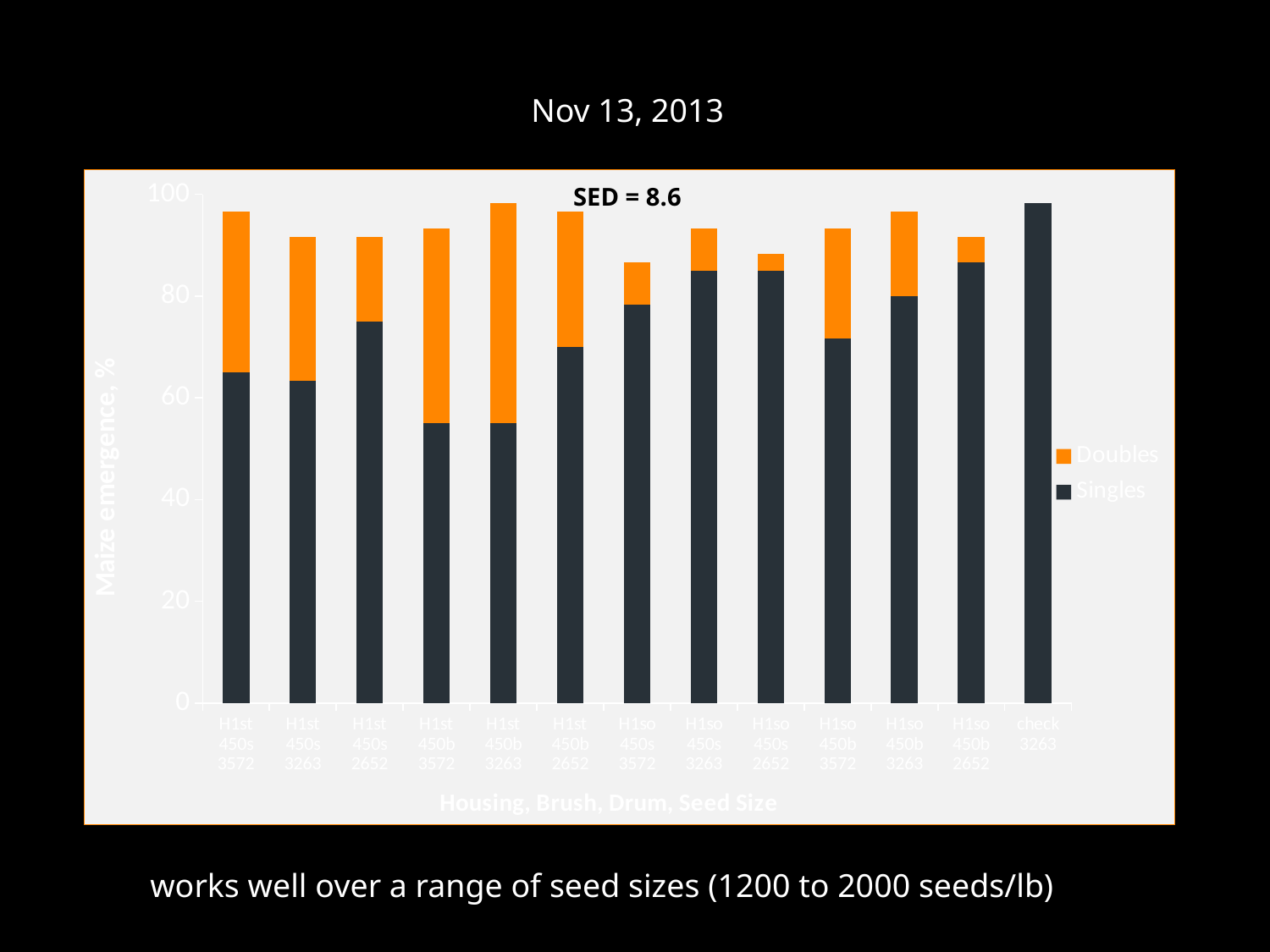
Is the Singles value for check 3263 greater or less than 80? greater How many series does the legend list? 2 Which has the larger Doubles value, H1st 450b 3263 or H1so 450s 3263? H1st 450b 3263 What SED value is printed on the chart? SED = 8.6 How many categories are plotted along the x axis? 13 What kind of chart is shown on the slide? stacked bar chart Is the Singles value for H1st 450b 3572 greater or less than 60? less What is the title of the y axis? Maize emergence, % Which has the larger Singles value, H1st 450s 2652 or H1st 450s 3263? H1st 450s 2652 Is the Singles value for H1so 450s 3263 greater or less than 80? greater Which category has the highest Singles value? check 3263